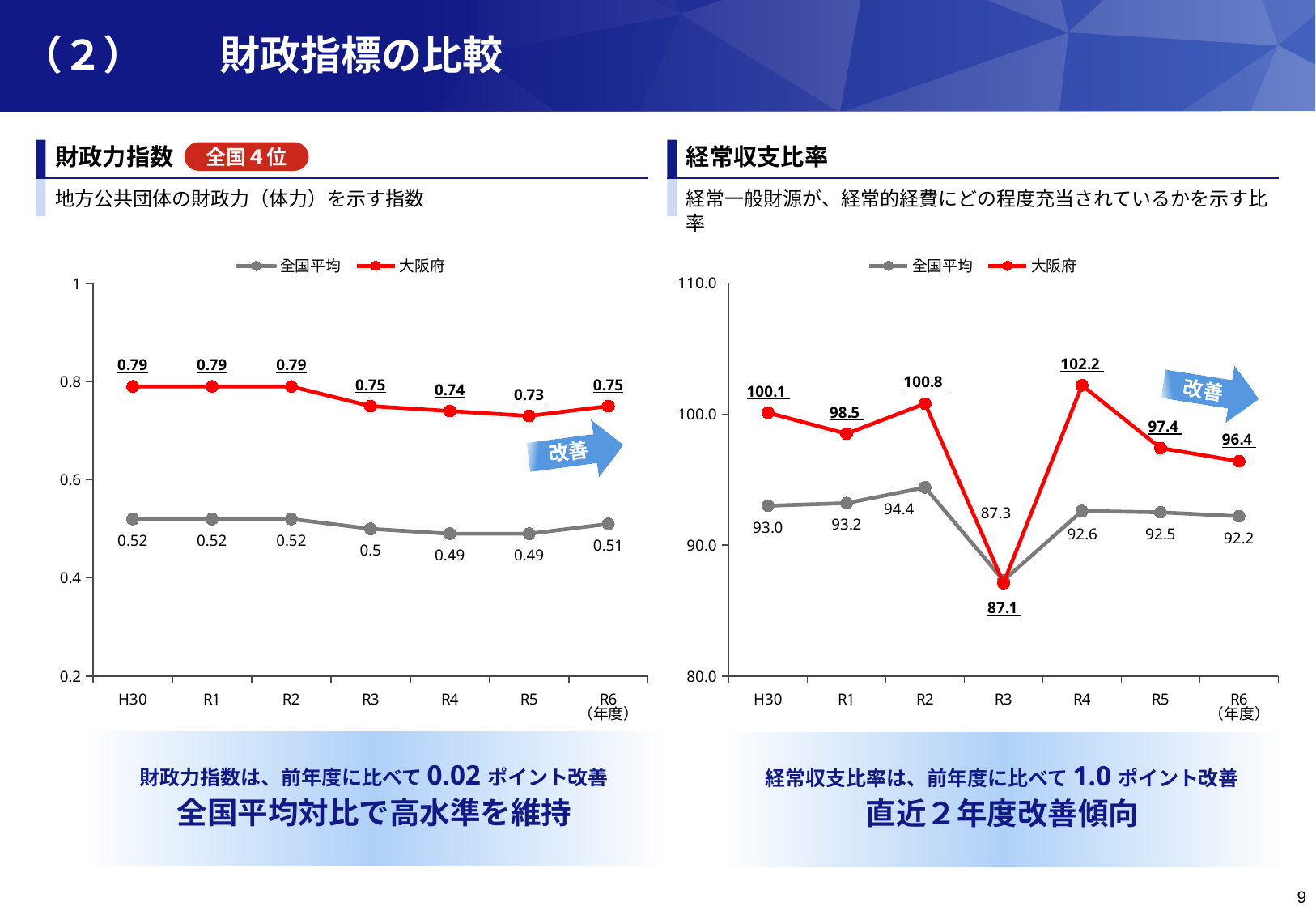
In the 財政力指数 chart on the left, what is the value for 大阪府 in R6? 0.75 In the 財政力指数 chart on the left, how many series does the legend list? 2 In the 経常収支比率 chart on the right, in which year is the 大阪府 value highest? R4 In the 経常収支比率 chart on the right, which is larger in R3, 大阪府 or 全国平均? 全国平均 What kind of chart is the 経常収支比率 chart on the right? Line chart In the 経常収支比率 chart on the right, what is the value for 全国平均 in R2? 94.4 In the 財政力指数 chart on the left, in which year is the 大阪府 value lowest? R5 In the 経常収支比率 chart on the right, what is the difference between the 大阪府 values in R5 and R6? 1.0 In the 財政力指数 chart on the left, what is the difference between 大阪府 and 全国平均 in R6? 0.24 In the 経常収支比率 chart on the right, what is the value for 大阪府 in R4? 102.2 In the 財政力指数 chart on the left, what is the value for 全国平均 in R4? 0.49 In the 財政力指数 chart on the left, how many years are plotted on the x axis? 7